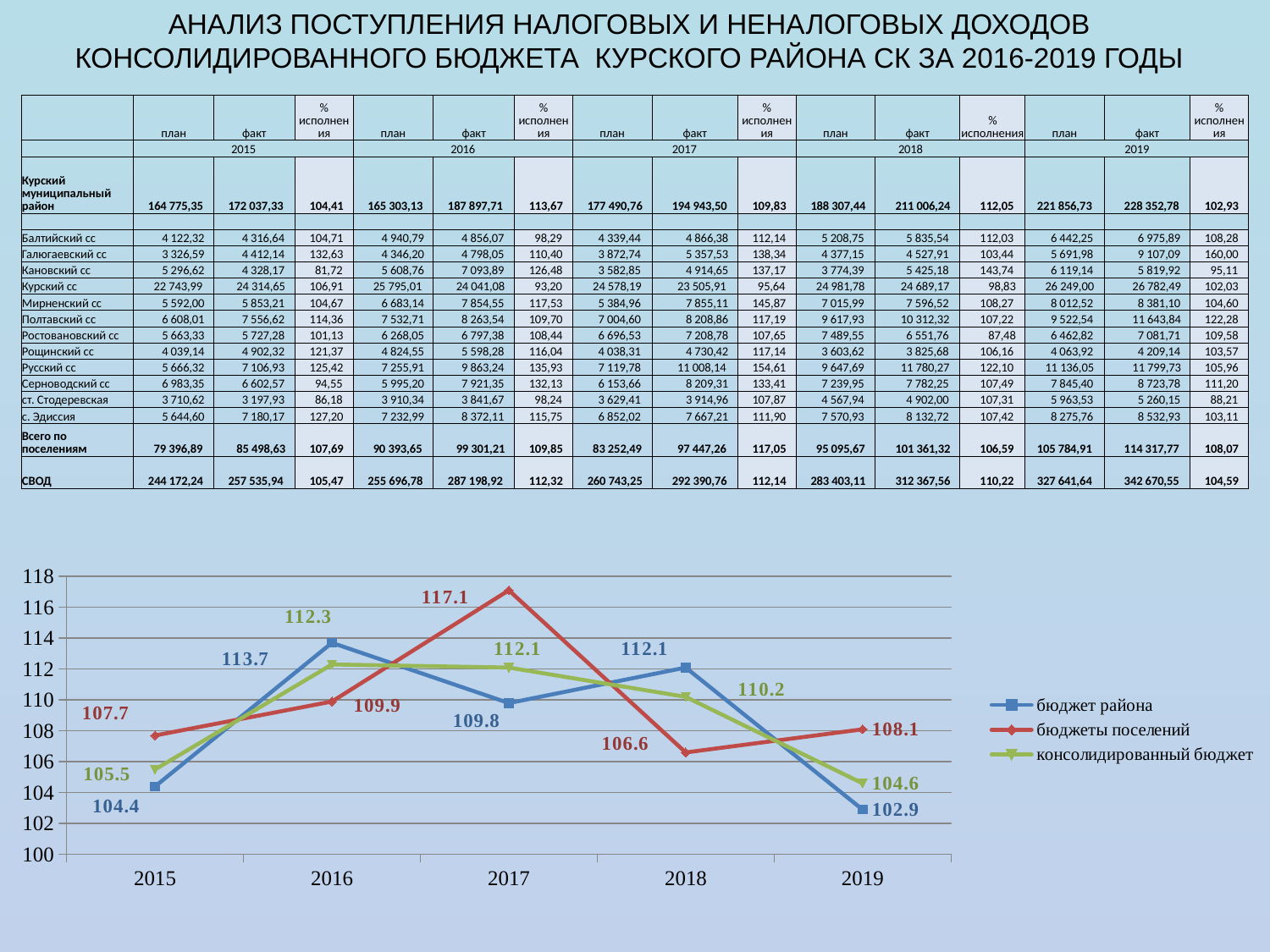
Which series has the higher value in 2017 on the chart: бюджет района or бюджеты поселений? бюджеты поселений What is the difference between бюджеты поселений and бюджет района in 2019 on the chart? 5.2 What is the value for бюджет района in 2015 on the chart? 104.4 What is the value for консолидированный бюджет in 2019 on the chart? 104.6 What kind of chart is shown at the bottom of the slide? line chart What is the value for бюджеты поселений in 2017 on the chart? 117.1 Does консолидированный бюджет rise or fall from 2017 to 2019 on the chart? fall In which year does бюджет района reach its highest value on the chart? 2016 In which year is бюджеты поселений lowest on the chart? 2018 How many years are plotted along the x axis of the chart? 5 How many series does the chart legend list? 3 Which colour is used for the консолидированный бюджет line on the chart? green